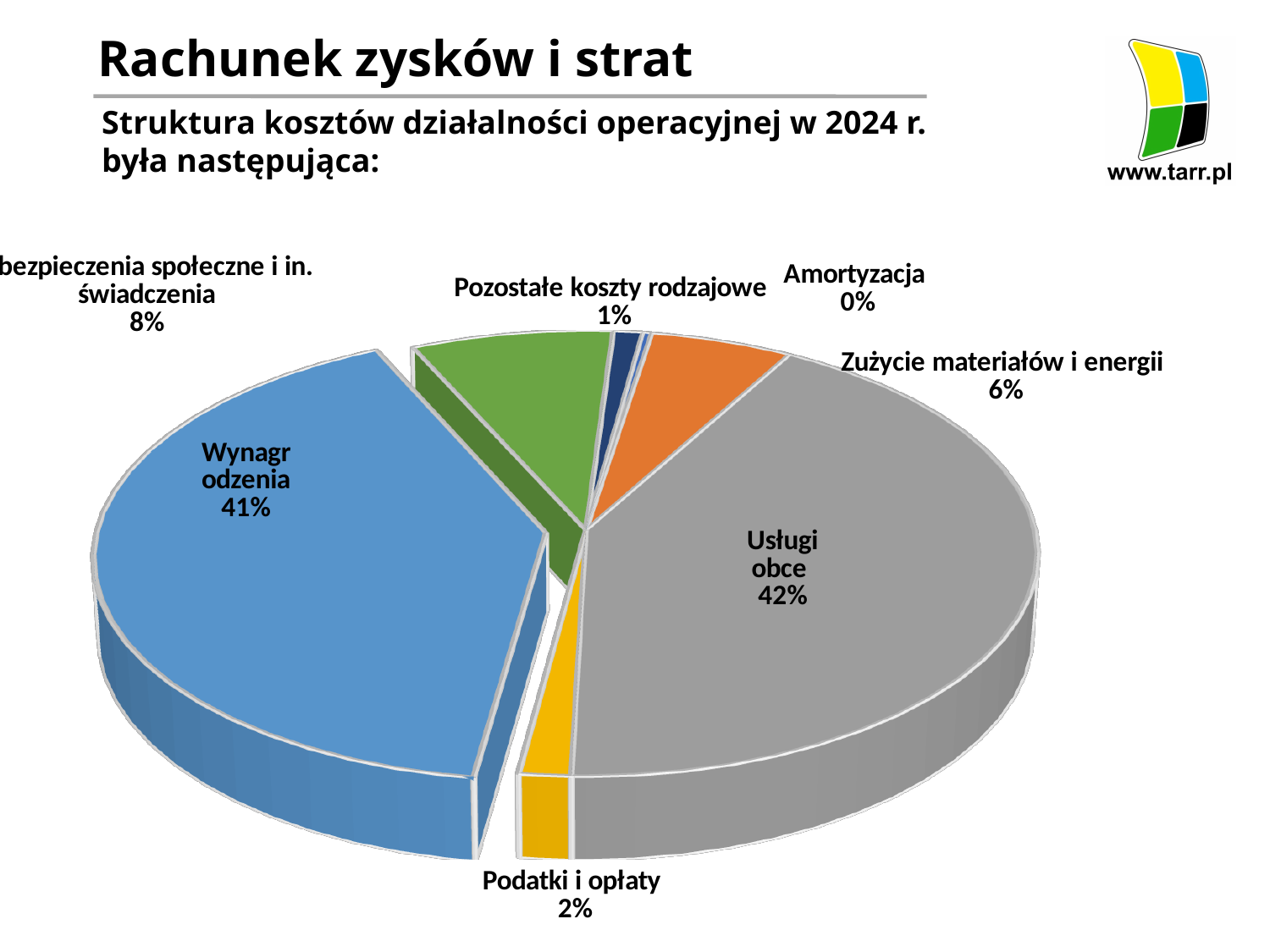
How many categories are shown in the pie chart? 7 What kind of chart is shown on the slide? Pie chart What percentage is shown for Pozostałe koszty rodzajowe? 1% What percentage is shown for Zużycie materiałów i energii? 6% What is the difference in percentage points between Usługi obce and Wynagrodzenia? 1 percentage point Which category has the smallest share of the pie? Amortyzacja What percentage is shown for Podatki i opłaty? 2% Which category has the largest share of the pie? Usługi obce What percentage is shown for Wynagrodzenia? 41% Which is larger, the share for Zużycie materiałów i energii or the share for Podatki i opłaty? Zużycie materiałów i energii What percentage is shown for Amortyzacja? 0% What share of operating costs is attributed to Usługi obce? 42%